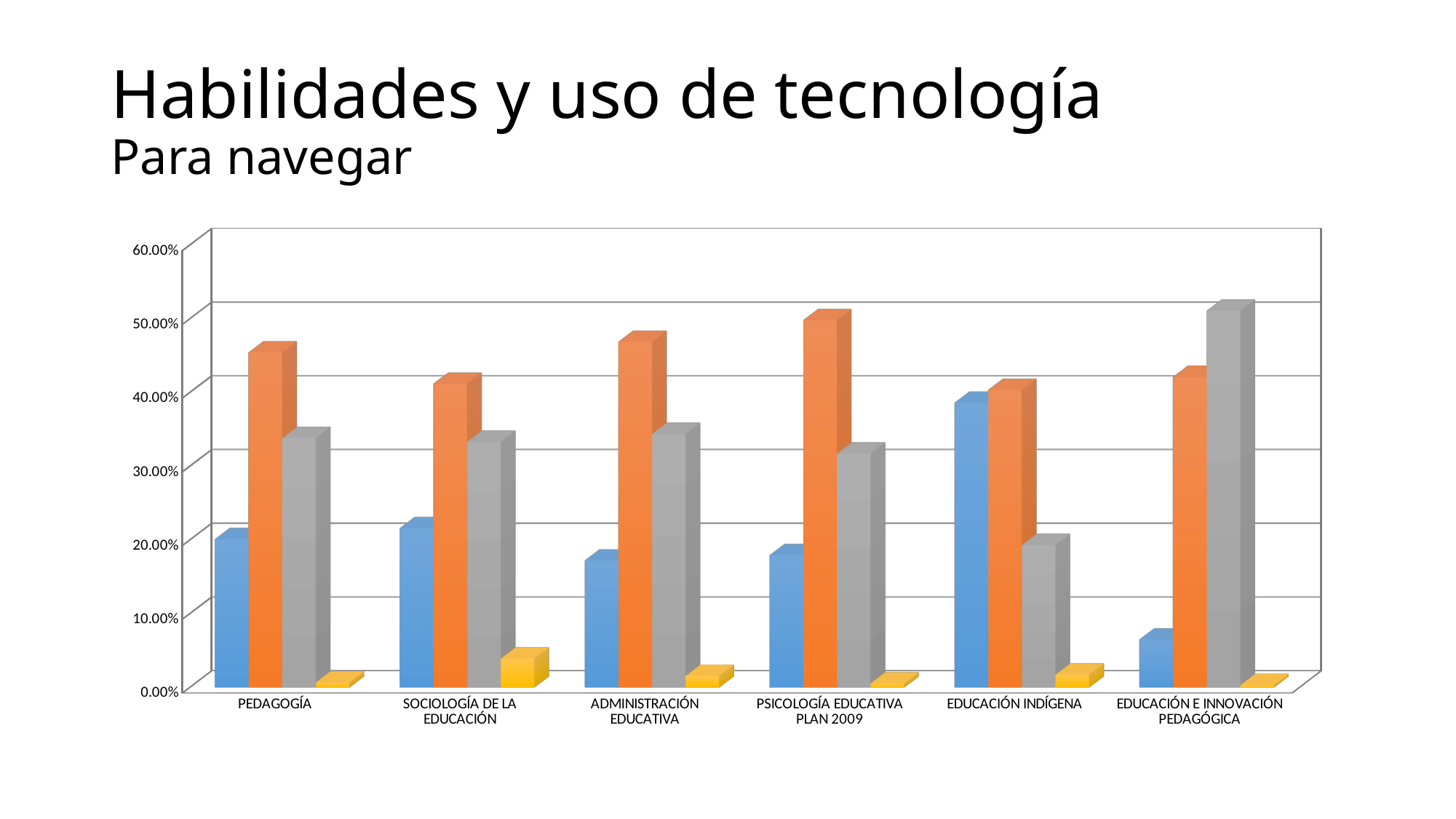
Is the blue bar for EDUCACIÓN E INNOVACIÓN PEDAGÓGICA greater or less than 10.00%? less Which category has the tallest blue bar? EDUCACIÓN INDÍGENA How many bars are plotted for each category in the chart? 4 Which category has the tallest gray bar? EDUCACIÓN E INNOVACIÓN PEDAGÓGICA What kind of chart is shown on the slide? bar chart Is the orange bar for PSICOLOGÍA EDUCATIVA PLAN 2009 greater or less than 40.00%? greater For EDUCACIÓN E INNOVACIÓN PEDAGÓGICA, which is larger, the gray bar or the orange bar? the gray bar Which category has the shortest blue bar? EDUCACIÓN E INNOVACIÓN PEDAGÓGICA What is the highest value shown on the vertical axis of the chart? 60.00% How many categories are shown along the x axis of the chart? 6 Is the blue bar for EDUCACIÓN INDÍGENA greater or less than 30.00%? greater